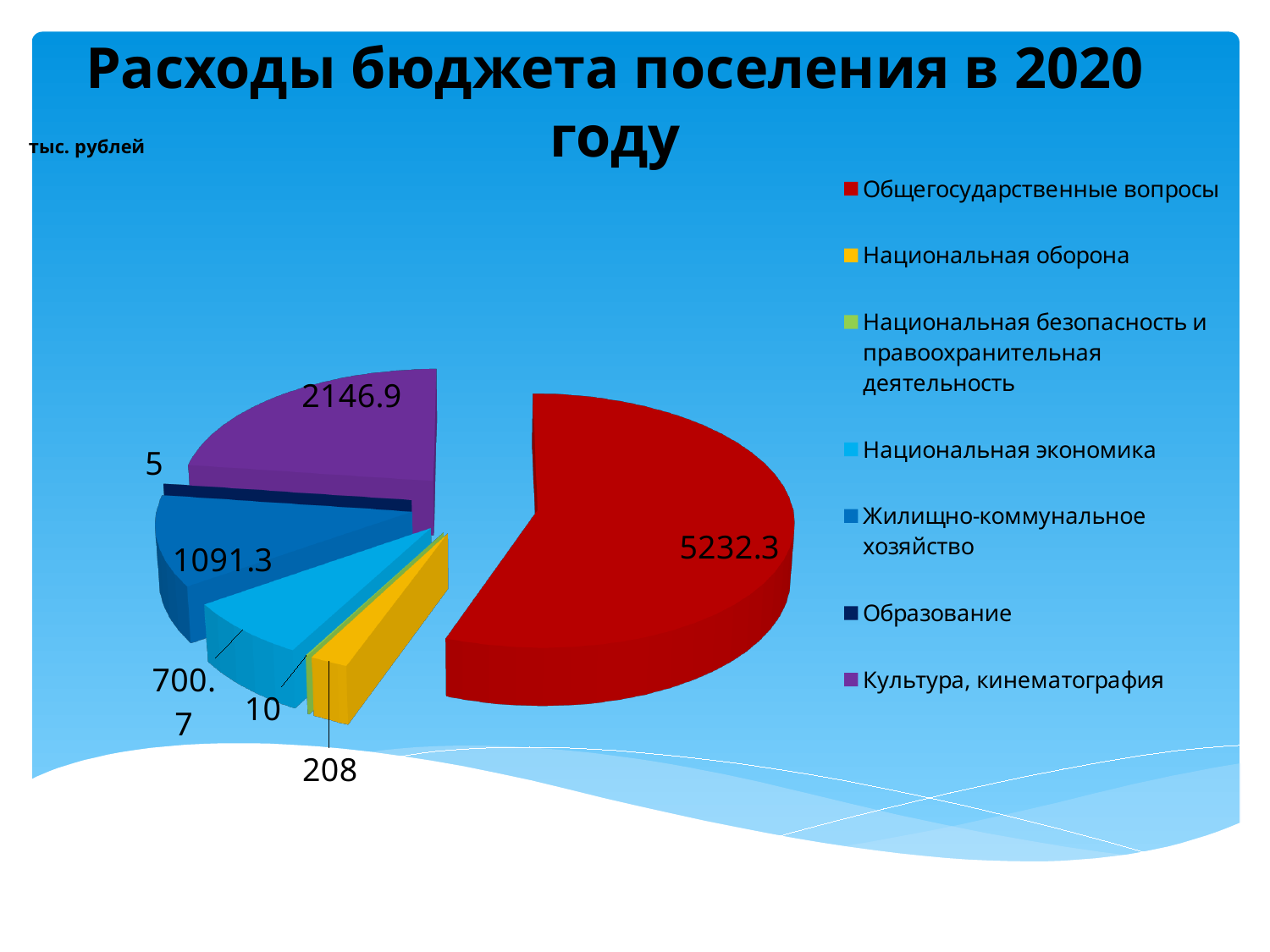
Which category has the largest value? Общегосударственные вопросы What is the value for Образование? 5 What is the value for Жилищно-коммунальное хозяйство? 1091.3 What type of chart is shown on the slide? pie chart What is the difference between the values for Культура, кинематография and Жилищно-коммунальное хозяйство? 1055.6 What is the value for Национальная оборона? 208 Which is larger: Национальная экономика or Национальная оборона? Национальная экономика What is the value for Культура, кинематография? 2146.9 How many categories does the legend list? 7 What unit is indicated in the top-left corner of the chart? тыс. рублей Which category has the smallest value? Образование What is the value for Общегосударственные вопросы? 5232.3